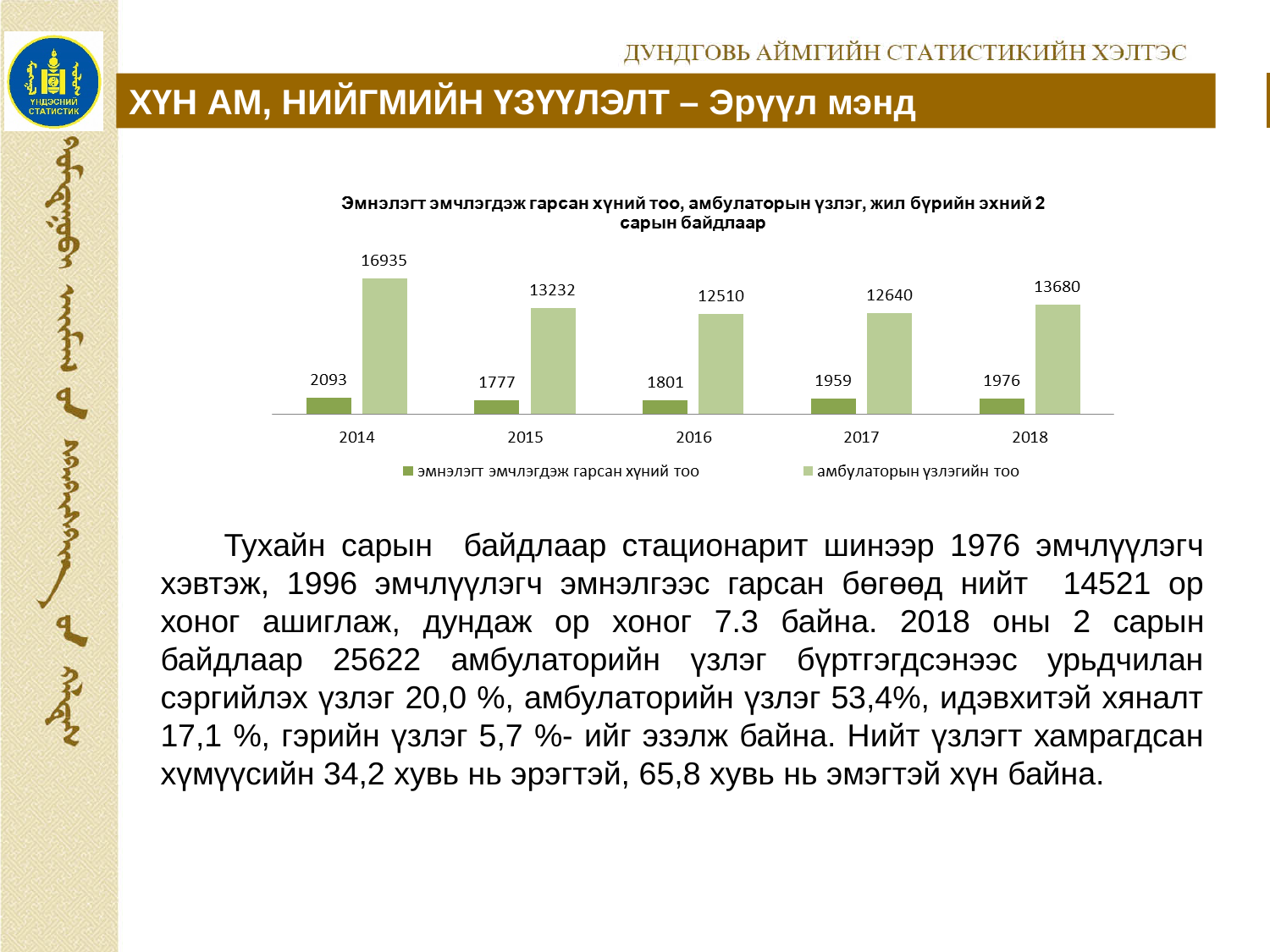
Which series is drawn in the lighter green colour? амбулаторын үзлэгийн тоо Does "амбулаторын үзлэгийн тоо" rise or fall from 2016 to 2018? Rise How many series does the chart's legend list? 2 What is the value for "амбулаторын үзлэгийн тоо" in 2018? 13680 Which is larger: "эмнэлэгт эмчлэгдэж гарсан хүний тоо" in 2017 or in 2016? 2017 How many years are shown on the x axis of the chart? 5 What is the value for "эмнэлэгт эмчлэгдэж гарсан хүний тоо" in 2014? 2093 In which year is "амбулаторын үзлэгийн тоо" highest? 2014 What kind of chart is shown on the slide? Bar chart In which year is "эмнэлэгт эмчлэгдэж гарсан хүний тоо" lowest? 2015 What is the difference between the "амбулаторын үзлэгийн тоо" values for 2014 and 2015? 3703 What is the value for "амбулаторын үзлэгийн тоо" in 2016? 12510